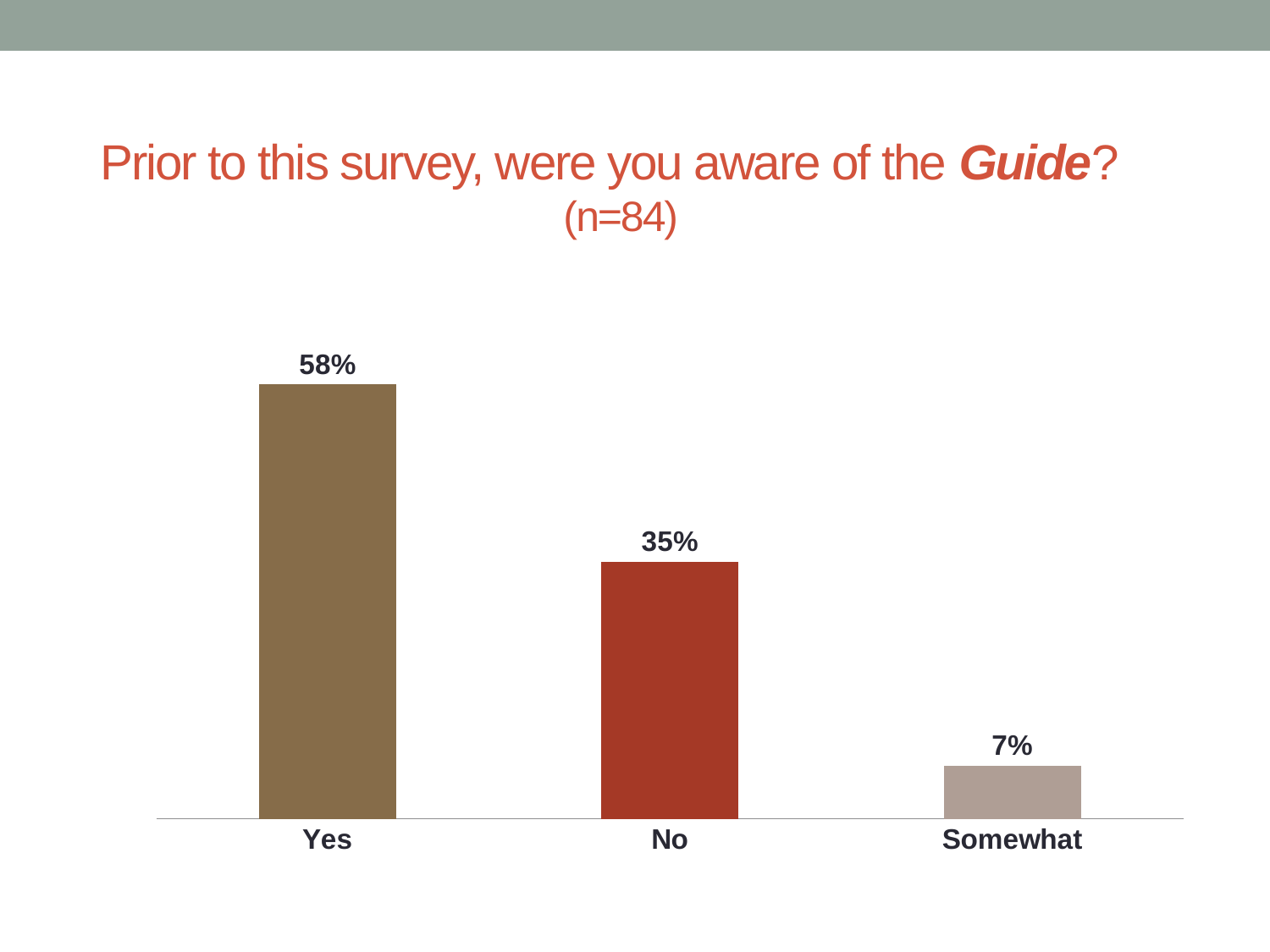
What percentage of respondents answered "No"? 35% Which response category has the highest value? Yes Which is larger, the value for "No" or the value for "Somewhat"? No What is the difference between the "No" and "Somewhat" percentages? 28% Which response category has the lowest value? Somewhat What percentage of respondents answered "Somewhat"? 7% Do the values rise or fall from left to right across the categories? Fall What kind of chart is shown on the slide? Bar chart How many response categories are shown in the chart? 3 What is the difference between the "Yes" and "No" percentages? 23% What sample size (n) is given in the slide title? n=84 What percentage of respondents answered "Yes"? 58%